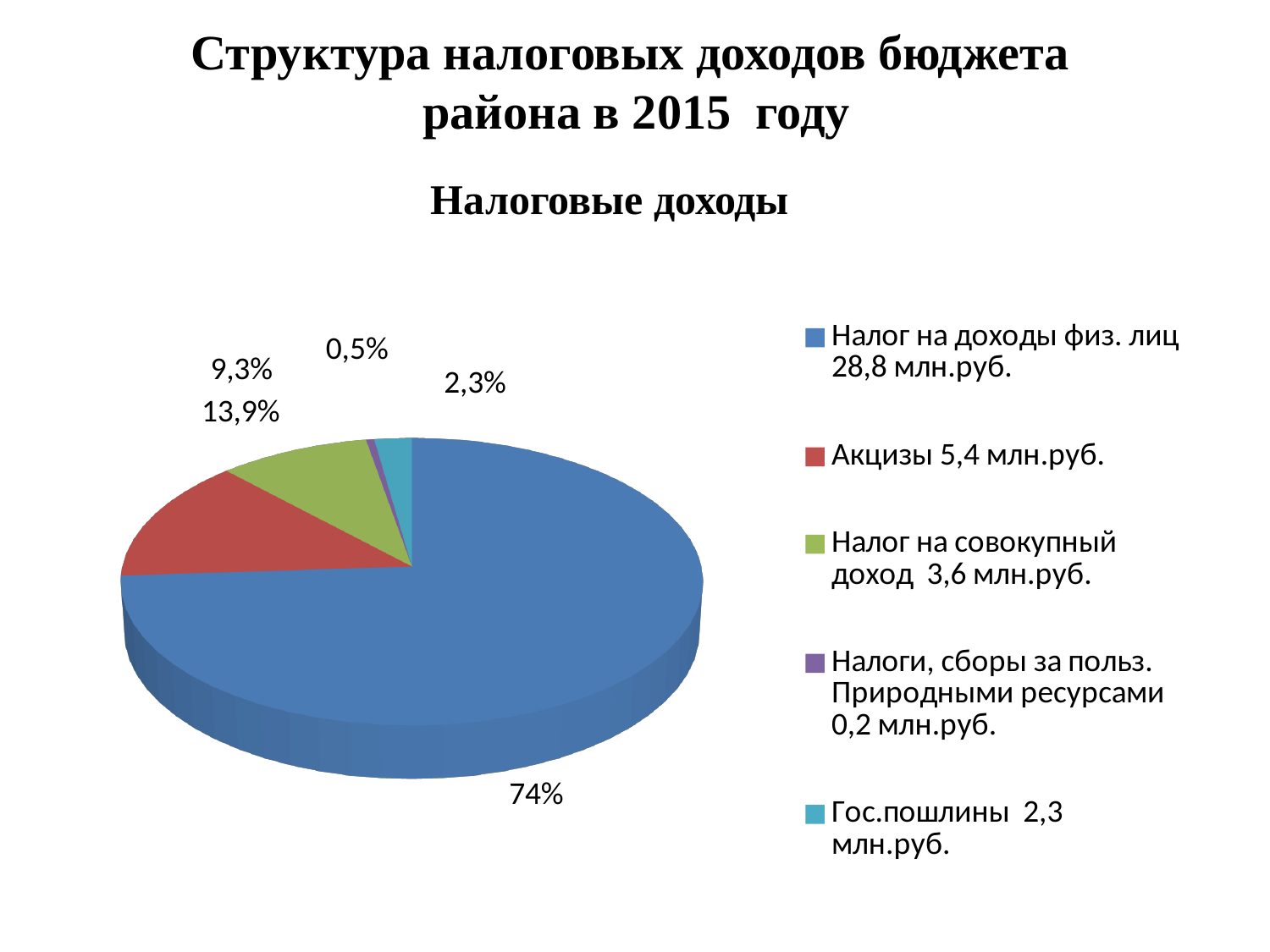
Which category has the largest slice in the pie chart? Налог на доходы физ. лиц What is the title of the chart? Налоговые доходы What percentage share does the slice for Налоги, сборы за польз. Природными ресурсами have? 0,5% Which category has the smallest slice in the pie chart? Налоги, сборы за польз. Природными ресурсами According to the legend, what is the amount for Акцизы? 5,4 млн.руб. What percentage share does the slice for Налог на доходы физ. лиц have? 74% According to the legend, what is the amount for Налог на совокупный доход? 3,6 млн.руб. How many slices does the pie chart have? 5 How many entries does the legend of the pie chart list? 5 What percentage share does the slice for Акцизы have? 13,9% What kind of chart is shown on the slide? pie chart